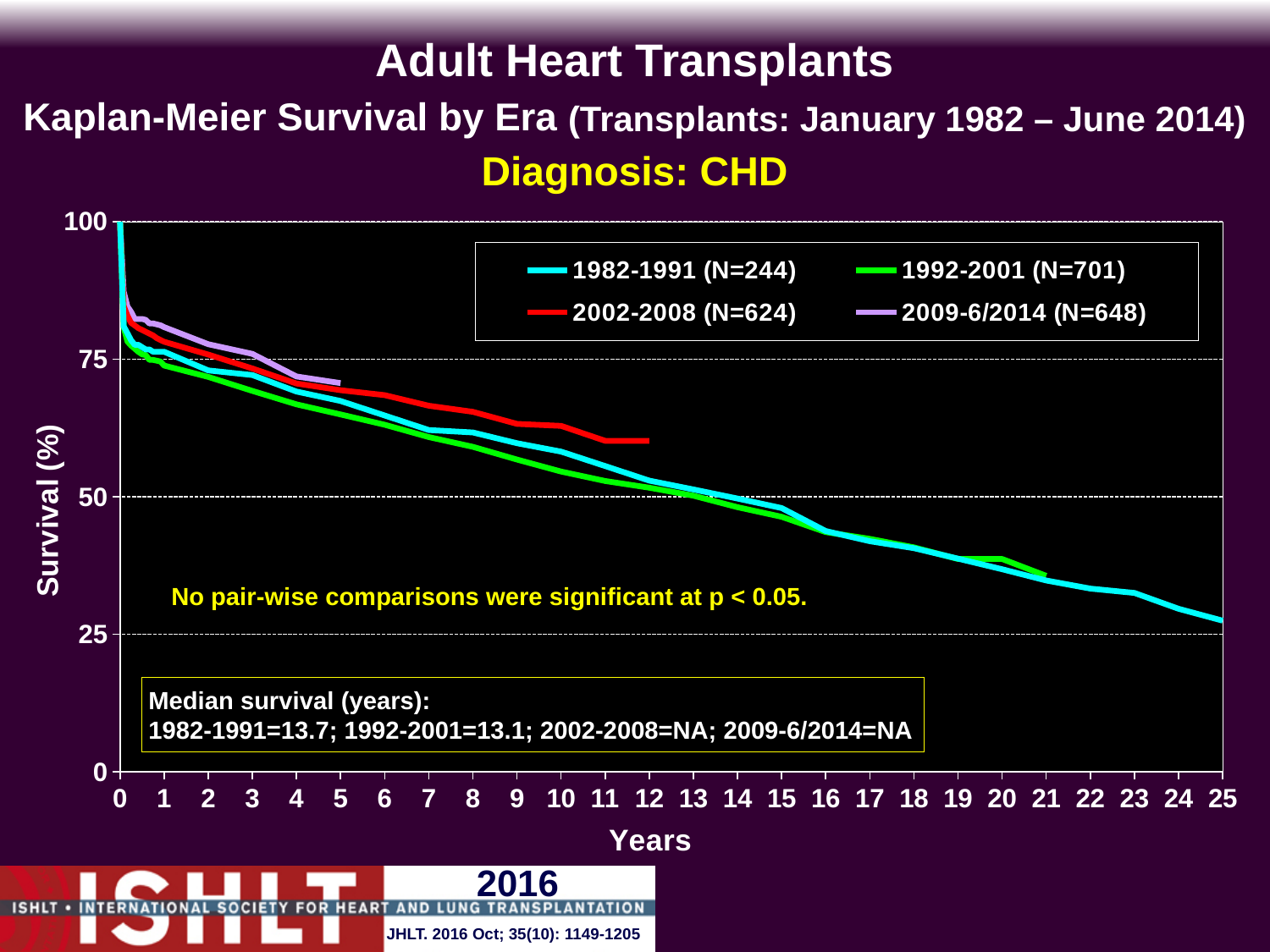
At 10 years, which era has higher survival: 2002-2008 or 1992-2001? 2002-2008 Is the survival for the 1982-1991 era at 20 years greater or less than 50%? less How many series (eras) does the legend list? 4 Do the survival curves rise or fall as years increase? Fall Is the survival for the 2002-2008 era at 10 years greater or less than 50%? greater What is the difference in median survival (years) between the 1982-1991 and 1992-2001 eras? 0.6 Which era has the largest number of transplants (N) in the legend? 1992-2001 (N=701) What is the N for the 1992-2001 era shown in the legend? 701 What kind of chart is shown on the slide? Line chart Which era has the smallest number of transplants (N) in the legend? 1982-1991 (N=244) What is the N for the 2009-6/2014 era shown in the legend? 648 What is the median survival in years for the 1982-1991 era? 13.7